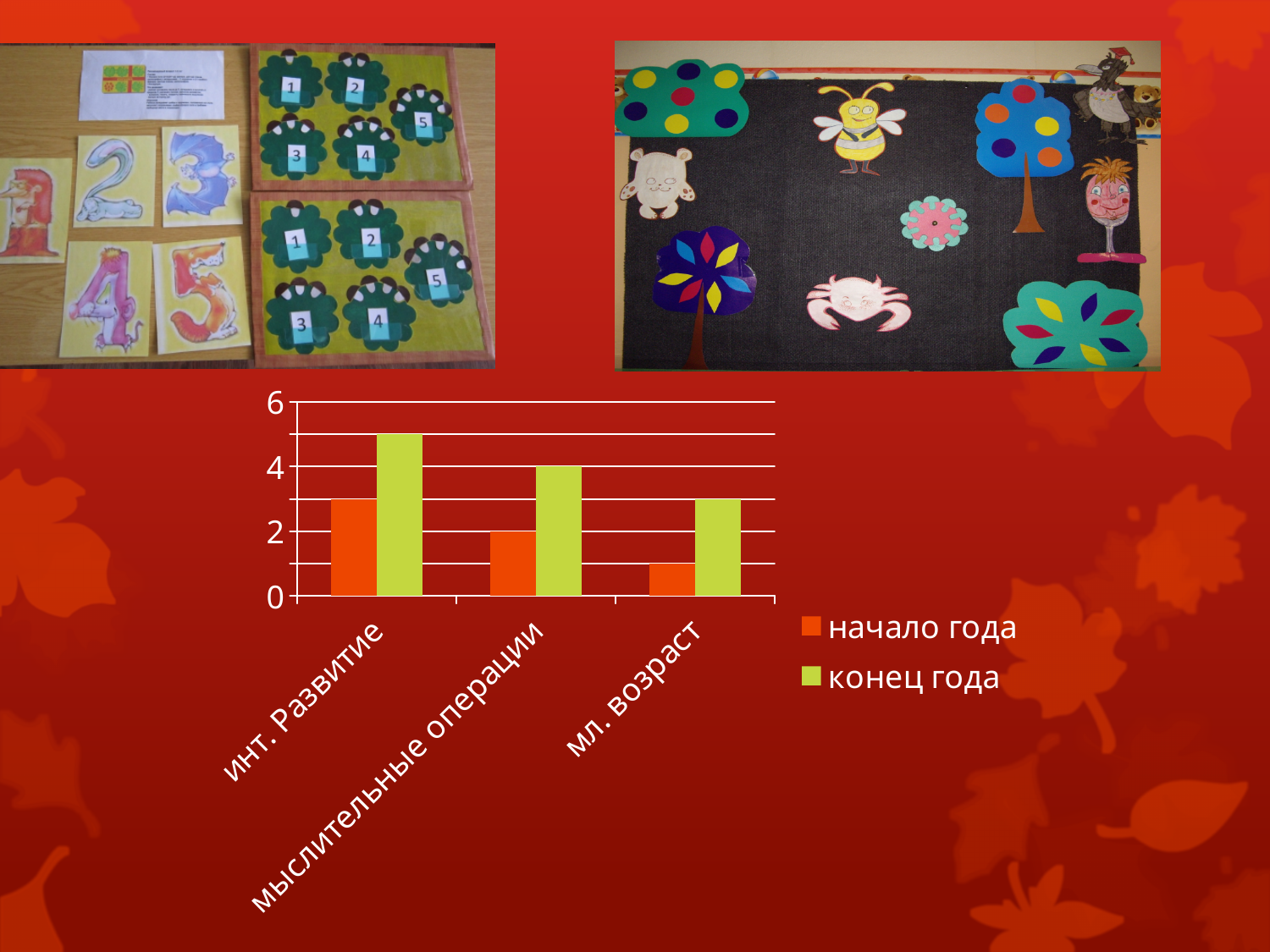
Is the value for 'начало года' in 'инт. Развитие' greater or less than 2? greater Which category has the lowest 'начало года' value? мл. возраст How many categories are shown on the x axis of the chart? 3 Is the value for 'конец года' in 'инт. Развитие' greater or less than 4? greater What colour are the bars for the series 'конец года'? green How many series does the chart legend list? 2 What is the value for 'начало года' in the category 'мыслительные операции'? 2 Which category has the highest 'конец года' value? инт. Развитие In the category 'мл. возраст', which is larger: 'начало года' or 'конец года'? конец года What kind of chart is shown on the slide? bar chart What is the value for 'конец года' in the category 'мыслительные операции'? 4 Is the value for 'начало года' in 'мл. возраст' greater or less than 2? less